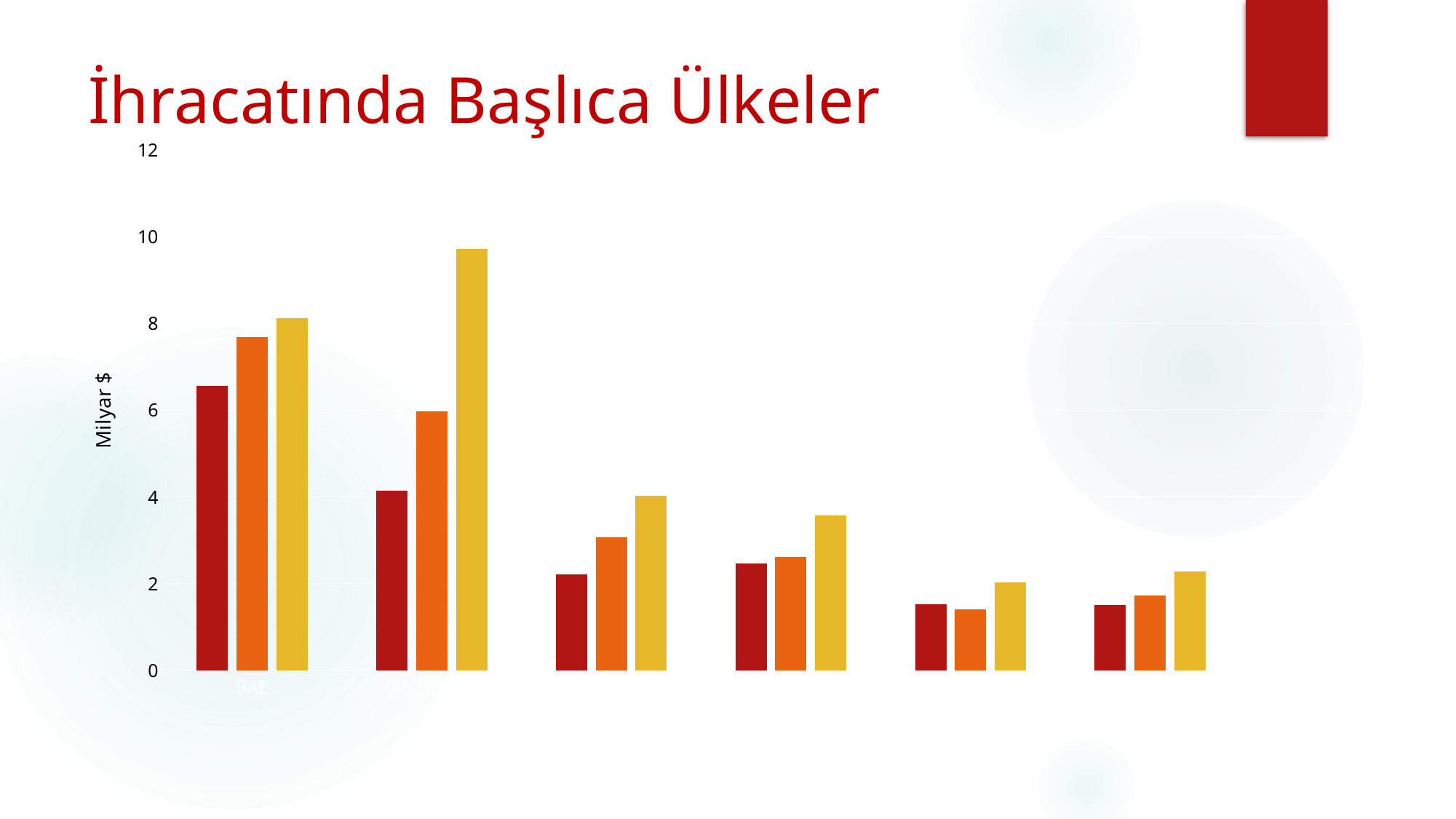
What kind of chart is shown on the slide? bar chart How many category groups of bars are plotted on the chart? 6 Is the value of the yellow (third) bar in the second category group from the left greater or less than 8? greater Is the value of the orange (second) bar for BAE greater or less than 8? less Is the value of the red (first) bar in the fourth category group from the left greater or less than 2? greater Which category group contains the tallest bar on the chart? the second group from the left What is the title of the slide containing the chart? İhracatında Başlıca Ülkeler How many bars are there in each category group? 3 What is the label of the vertical axis? Milyar $ For BAE, which is larger: the red (first) bar or the yellow (third) bar? the yellow (third) bar Which is larger: the red (first) bar for BAE or the red (first) bar in the second category group from the left? the red bar for BAE